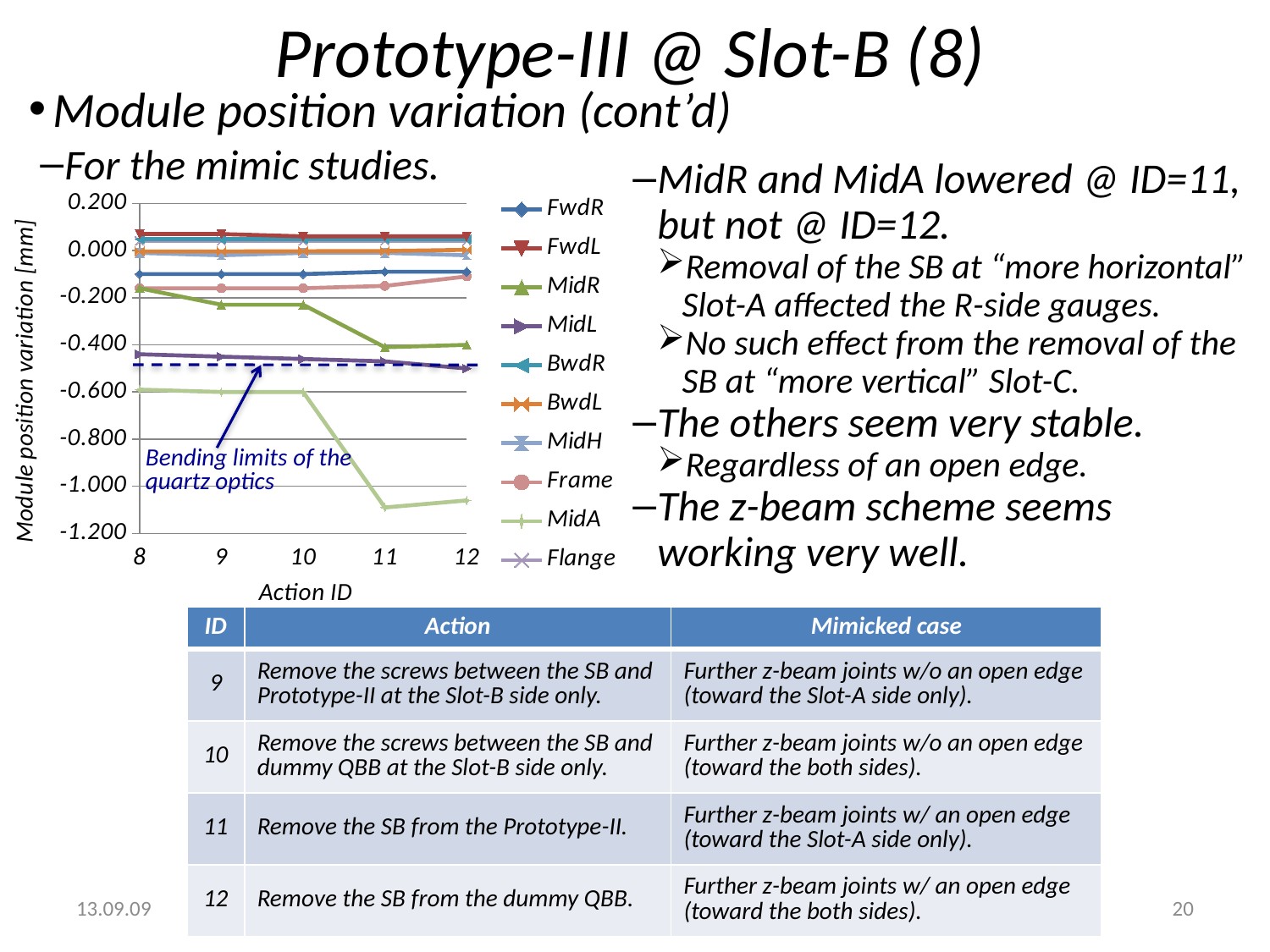
Which series has the highest values across the chart? FwdL What is the label of the y axis of the chart? Module position variation [mm] Is the value for FwdR at Action ID 12 greater or less than -0.200? greater Which series has the lowest value at Action ID 11? MidA At Action ID 11, which is larger, the value for MidR or the value for MidA? MidR What kind of chart is shown on the slide? line chart How many series does the chart legend list? 10 Is the value for MidL at Action ID 10 greater or less than -0.600? greater Is the value for MidR at Action ID 8 greater or less than -0.200? greater How many Action ID values are plotted along the x axis? 5 Does the MidA series rise or fall from Action ID 8 to Action ID 12? fall